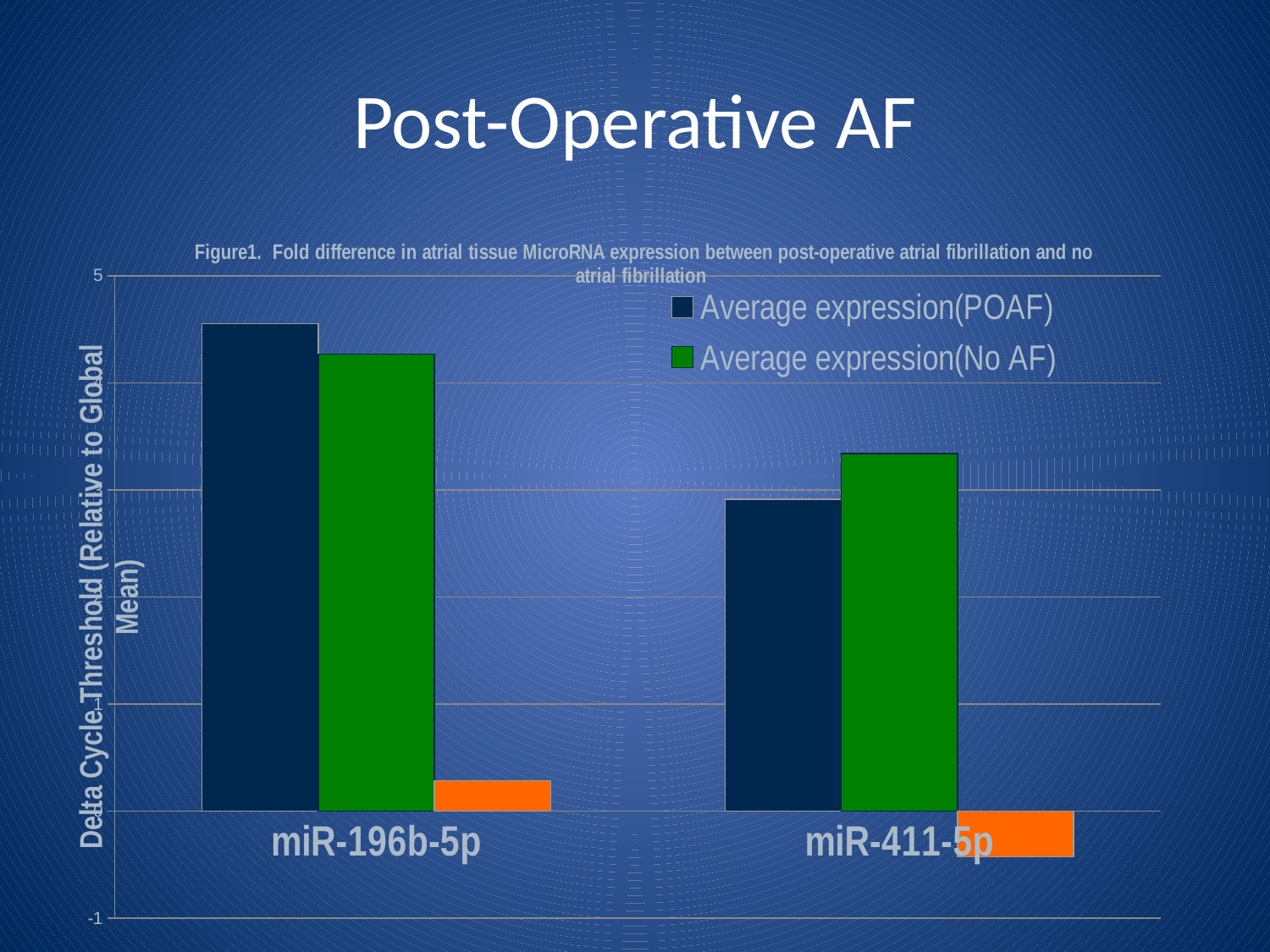
What is the title of the vertical axis? Delta Cycle Threshold (Relative to Global Mean) Is the Average expression(POAF) value for miR-411-5p greater or less than 2? greater Is the Average expression(POAF) value for miR-196b-5p greater or less than 4? greater Which category has the higher Average expression(POAF) value? miR-196b-5p Which category has the lower Average expression(No AF) value? miR-411-5p How many microRNA categories are shown on the x axis? 2 What kind of chart is shown on the slide? Bar chart Which series has the taller bar for miR-411-5p, Average expression(POAF) or Average expression(No AF)? Average expression(No AF) Is the Average expression(No AF) value for miR-411-5p greater or less than 3? greater What colour represents Average expression(No AF) in the legend? Green Which series has the taller bar for miR-196b-5p, Average expression(POAF) or Average expression(No AF)? Average expression(POAF) How many series does the chart legend list? 2